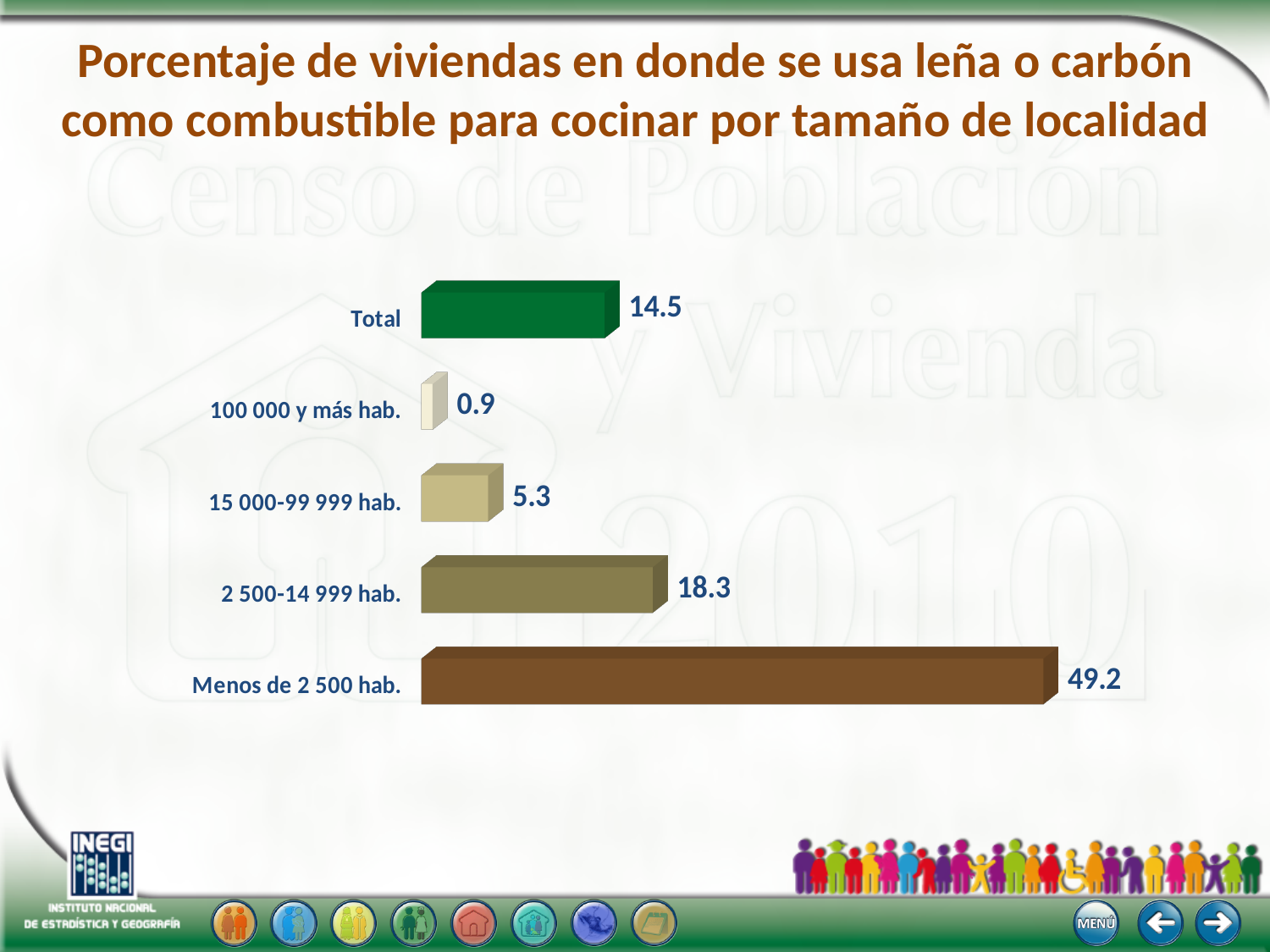
What kind of chart is shown on the slide? Bar chart Which category has the lowest value? 100 000 y más hab. What colour is the bar for Total? Green How many categories are shown in the chart? 5 What is the value for 2 500-14 999 hab.? 18.3 What is the value for Menos de 2 500 hab.? 49.2 Which is larger, the value for Total or the value for 15 000-99 999 hab.? Total What is the value for Total? 14.5 What is the value for 100 000 y más hab.? 0.9 Which category has the highest value? Menos de 2 500 hab. What is the difference between the values for Menos de 2 500 hab. and 2 500-14 999 hab.? 30.9 What is the difference between the values for 15 000-99 999 hab. and 100 000 y más hab.? 4.4